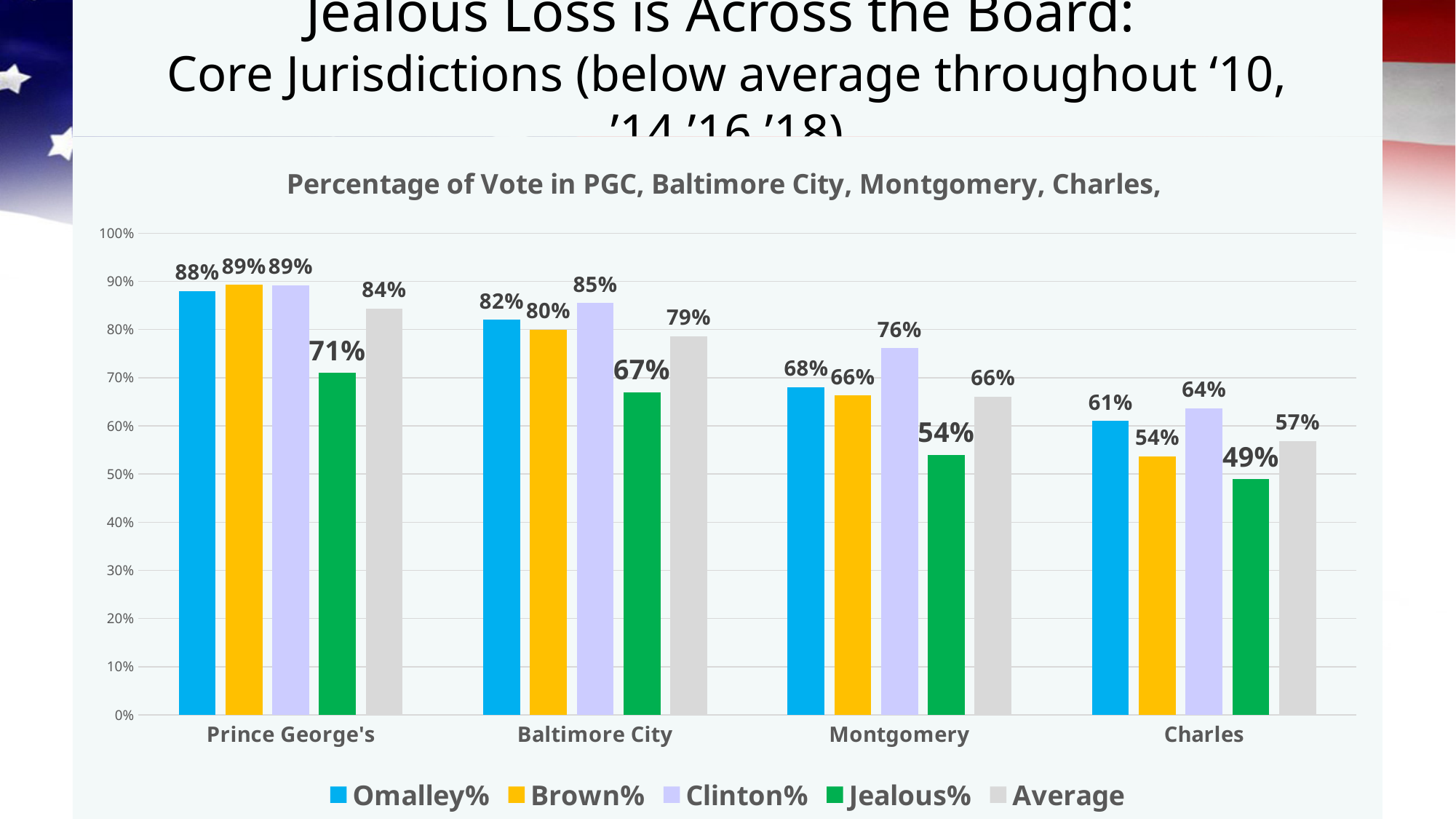
What is the Jealous% value for Prince George's? 71% Which jurisdiction has the highest Average value? Prince George's Which jurisdiction has the lowest Jealous% value? Charles How many jurisdictions are shown on the x axis? 4 How many series does the legend list? 5 What kind of chart is shown on the slide? Bar chart Which is larger for Montgomery, the Omalley% value or the Brown% value? Omalley% What is the difference between the Average and the Jealous% value for Baltimore City? 12% What is the Clinton% value for Montgomery? 76% Which colour represents the Jealous% series in the legend? Green What is the Omalley% value for Baltimore City? 82% What is the Average value for Charles? 57%